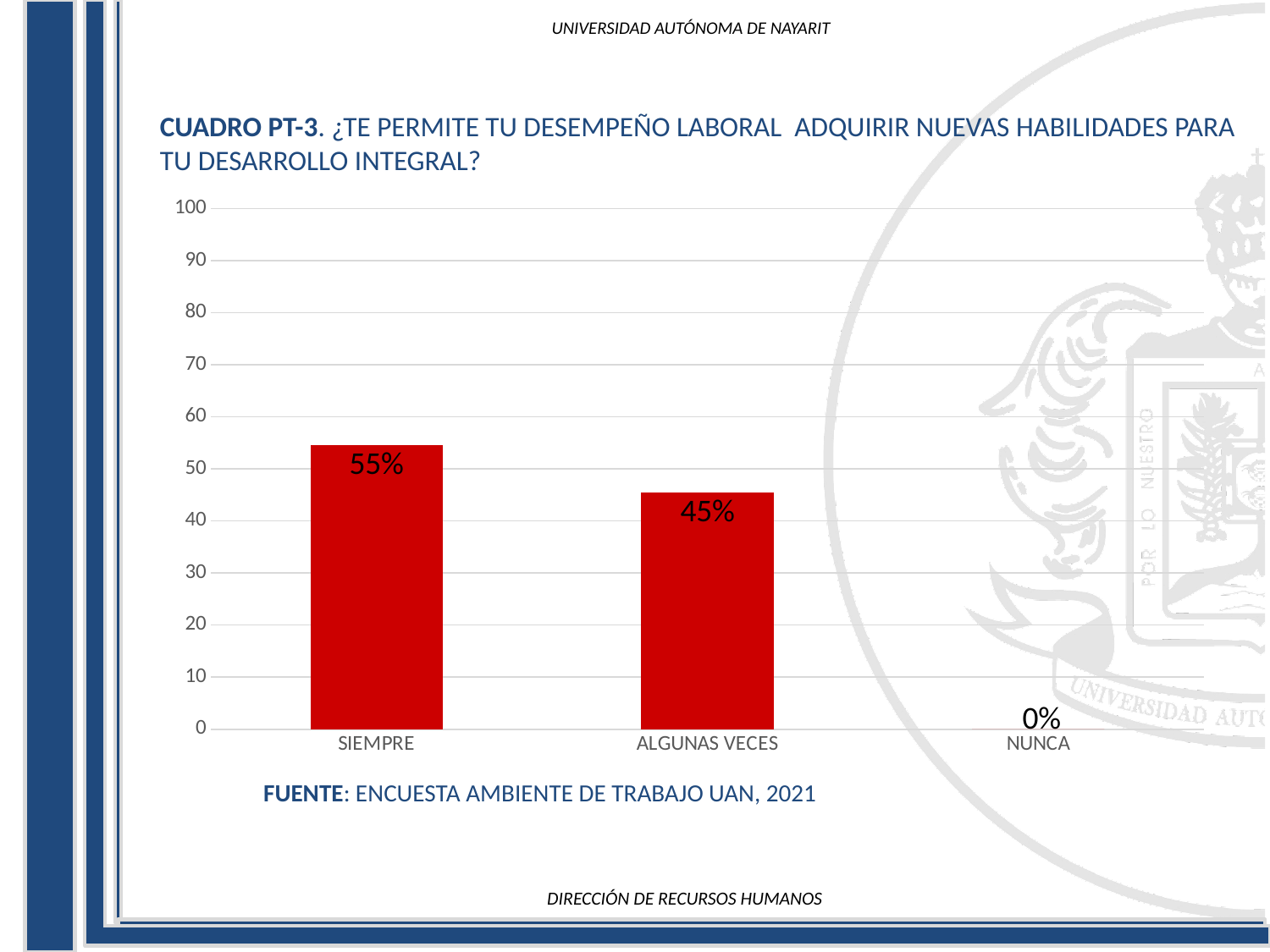
What is the difference between the values for SIEMPRE and ALGUNAS VECES? 10% Is the value for ALGUNAS VECES greater or less than 50? less Do the values rise or fall from left to right along the x axis? fall What kind of chart is shown on the slide? bar chart What source is cited below the chart? ENCUESTA AMBIENTE DE TRABAJO UAN, 2021 What is the value for SIEMPRE? 55% Which is larger, the value for SIEMPRE or the value for ALGUNAS VECES? SIEMPRE What is the value for ALGUNAS VECES? 45% What is the value for NUNCA? 0% Which category has the lowest value? NUNCA Which category has the highest value? SIEMPRE How many categories are shown on the x axis? 3